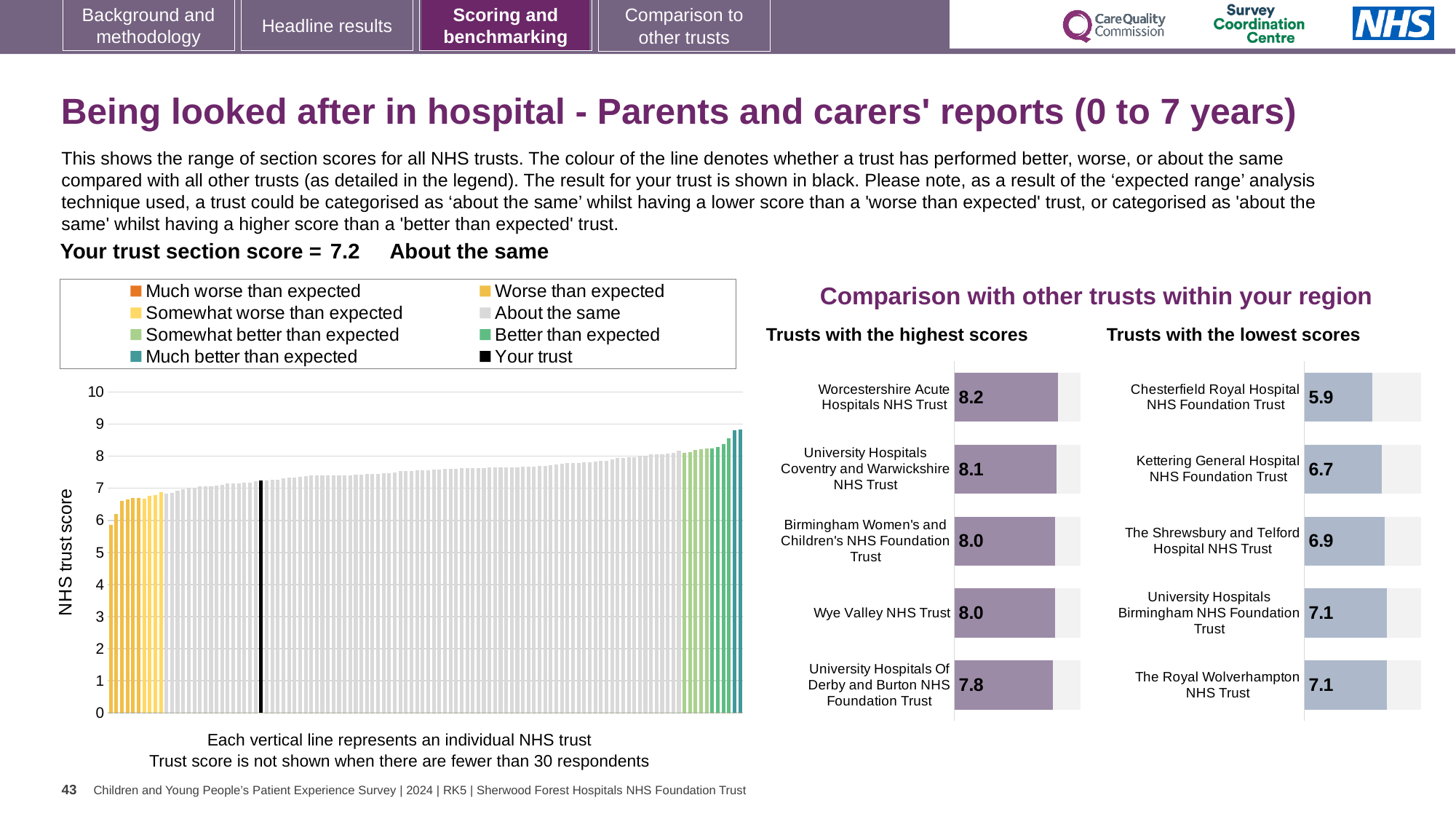
In the 'Trusts with the lowest scores' chart, what is the value for The Royal Wolverhampton NHS Trust? 7.1 In the 'Trusts with the highest scores' chart, what is the value for Worcestershire Acute Hospitals NHS Trust? 8.2 In the large chart on the left, do the bar values rise or fall from left to right? rise In the large chart on the left, how many entries does the legend list? 8 How many trusts are shown in the 'Trusts with the highest scores' chart? 5 In the 'Trusts with the highest scores' chart, what is the difference between the scores of Worcestershire Acute Hospitals NHS Trust and University Hospitals Of Derby and Burton NHS Foundation Trust? 0.4 In the large chart on the left, is the value of the tallest bar greater or less than 8? greater In the 'Trusts with the highest scores' chart, which trust has the lowest score? University Hospitals Of Derby and Burton NHS Foundation Trust In the 'Trusts with the lowest scores' chart, which has the larger score: Kettering General Hospital NHS Foundation Trust or The Shrewsbury and Telford Hospital NHS Trust? The Shrewsbury and Telford Hospital NHS Trust In the large chart on the left, is the value of the black 'Your trust' bar greater or less than 8? less In the 'Trusts with the lowest scores' chart, which trust has the lowest score? Chesterfield Royal Hospital NHS Foundation Trust What type of chart is the large chart on the left with the y-axis labelled 'NHS trust score'? bar chart